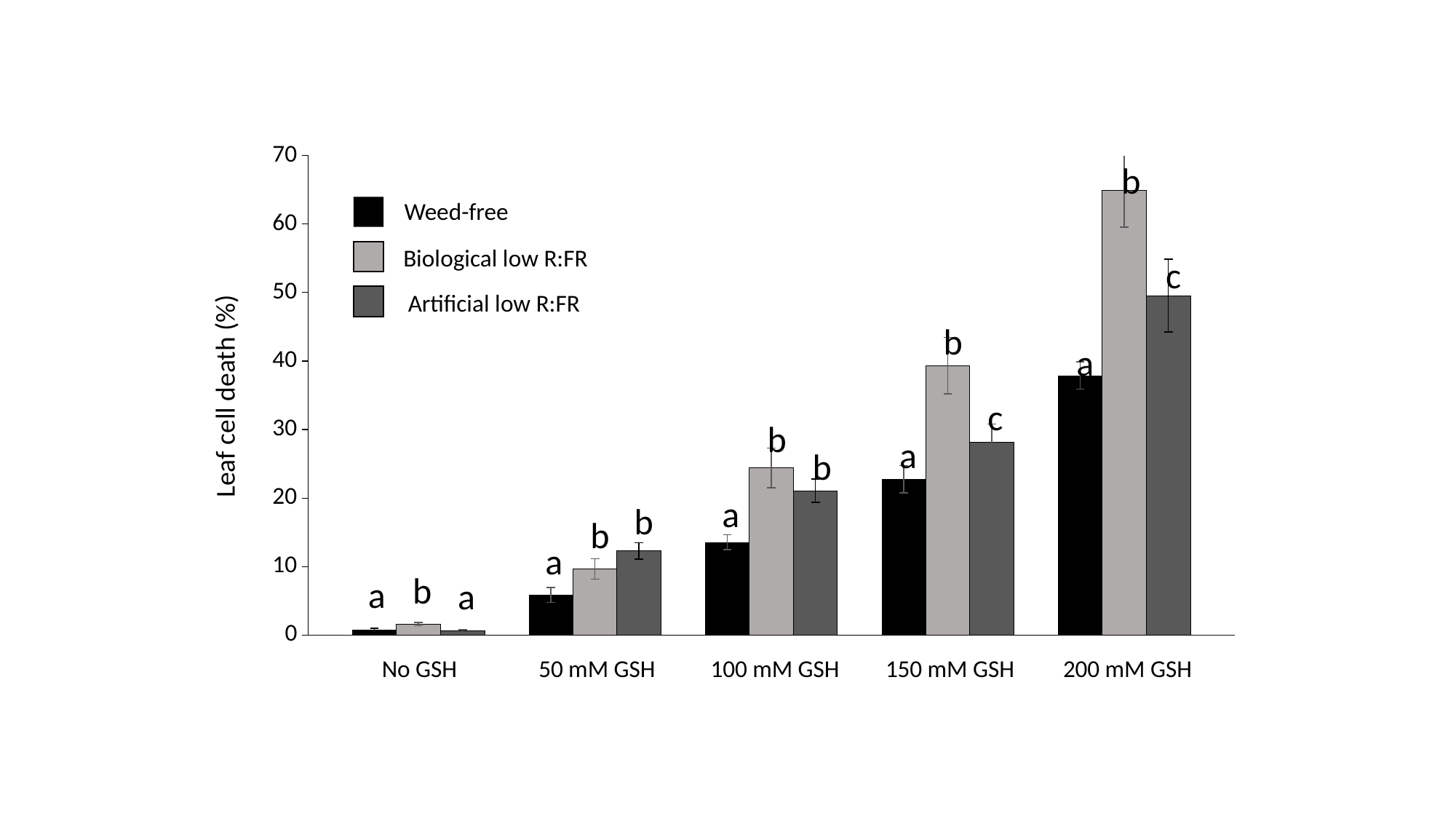
What is the label of the y axis? Leaf cell death (%) Do the Weed-free values rise or fall as GSH concentration increases along the x axis? rise At 50 mM GSH, which is larger: Biological low R:FR or Artificial low R:FR? Artificial low R:FR Which category has the highest value for Biological low R:FR? 200 mM GSH Which series has the lowest value at 200 mM GSH? Weed-free Is the value for Weed-free at 200 mM GSH greater or less than 40? less How many GSH treatment categories are shown on the x axis? 5 Is the value for Biological low R:FR at 200 mM GSH greater or less than 60? greater Is the value for Biological low R:FR at 150 mM GSH greater or less than 30? greater What kind of chart is shown on the slide? bar chart How many series does the legend list? 3 At 150 mM GSH, which is larger: Weed-free or Artificial low R:FR? Artificial low R:FR